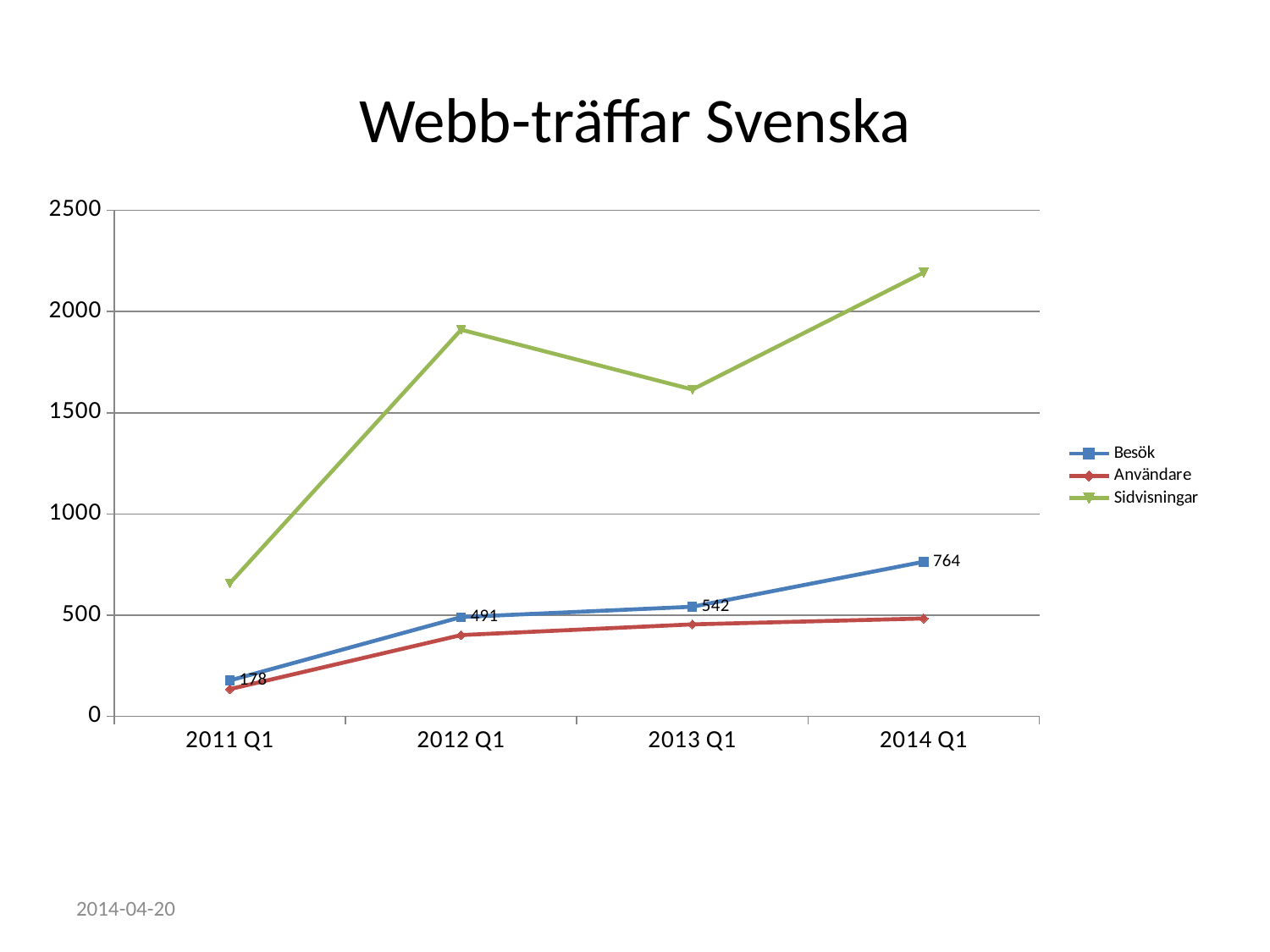
What is the value of Besök for 2012 Q1? 491 What is the value of Besök for 2011 Q1? 178 In which quarter is the Besök value lowest? 2011 Q1 What is the value of Besök for 2014 Q1? 764 How many series does the legend list? 3 How many quarters are shown on the x axis? 4 What kind of chart is shown on the slide? line chart Is the value for Sidvisningar in 2011 Q1 greater or less than 1000? less What is the difference between the Besök values for 2014 Q1 and 2011 Q1? 586 Is the value for Sidvisningar in 2014 Q1 greater or less than 2000? greater In which quarter is the Besök value highest? 2014 Q1 Which is larger for Sidvisningar: the value in 2012 Q1 or in 2013 Q1? 2012 Q1